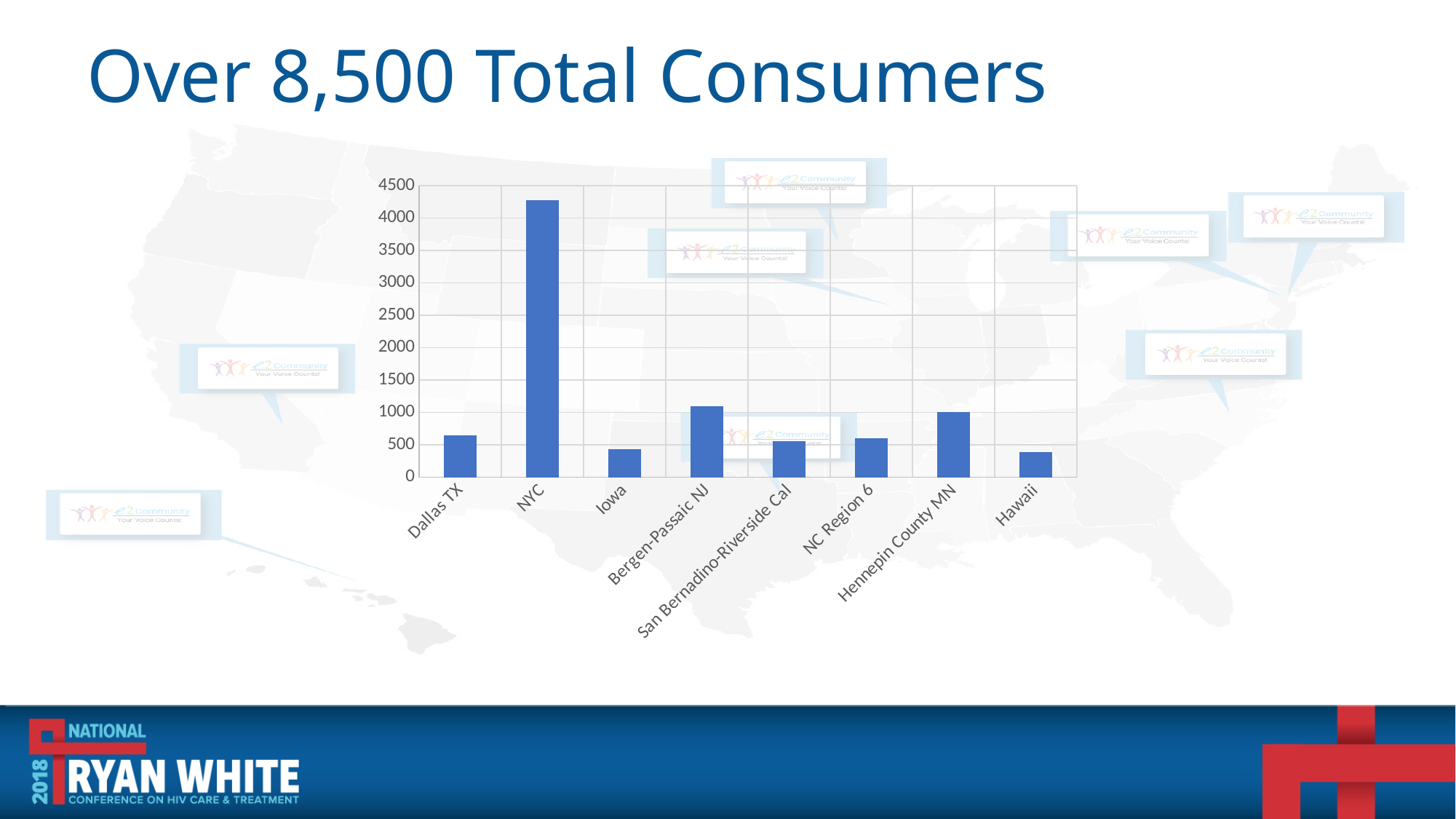
Which is larger, the value for Hennepin County MN or the value for Hawaii? Hennepin County MN Is the value for Dallas TX greater or less than 500? greater Which category has the highest value on the chart? NYC Is the value for Bergen-Passaic NJ greater or less than 500? greater What kind of chart is shown on the slide? bar chart Is the value for Hawaii greater or less than 500? less Which is larger, the value for NYC or the value for Dallas TX? NYC Which is larger, the value for Bergen-Passaic NJ or the value for Iowa? Bergen-Passaic NJ What is the title of the slide containing the chart? Over 8,500 Total Consumers How many categories are plotted on the chart? 8